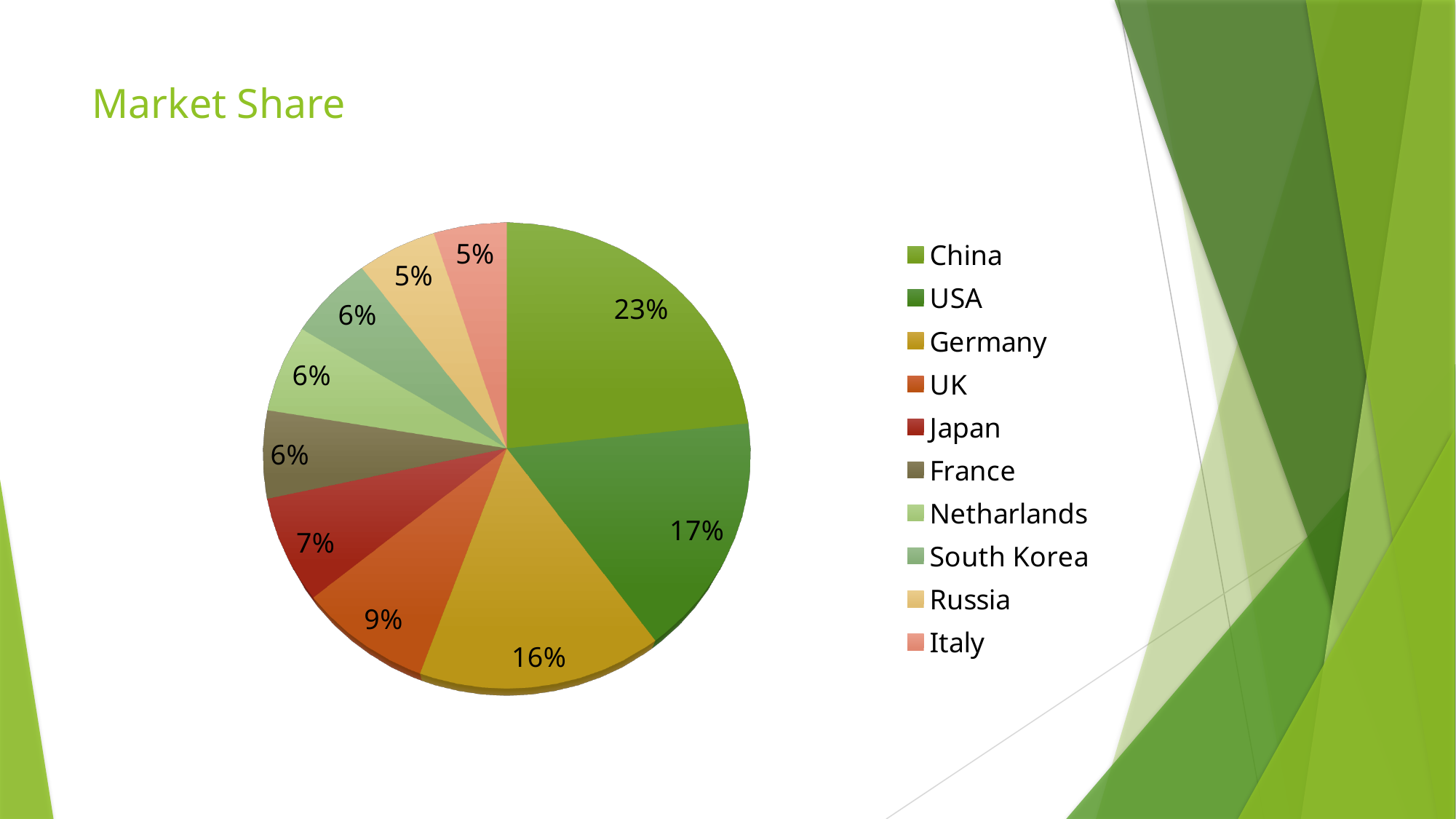
What is the value for Russia? 5% What is the value for Japan? 7% What is the title of the chart? Market Share What is the difference between the shares of China and USA? 6% Which is larger, the share for USA or the share for Germany? USA What is the difference between the shares of the UK and Japan? 2% What share of the pie does China hold? 23% Which country has the largest slice of the pie? China What share of the pie does Germany hold? 16% What type of chart is shown on the slide? Pie chart How many categories does the legend list? 10 What is the value for the UK? 9%